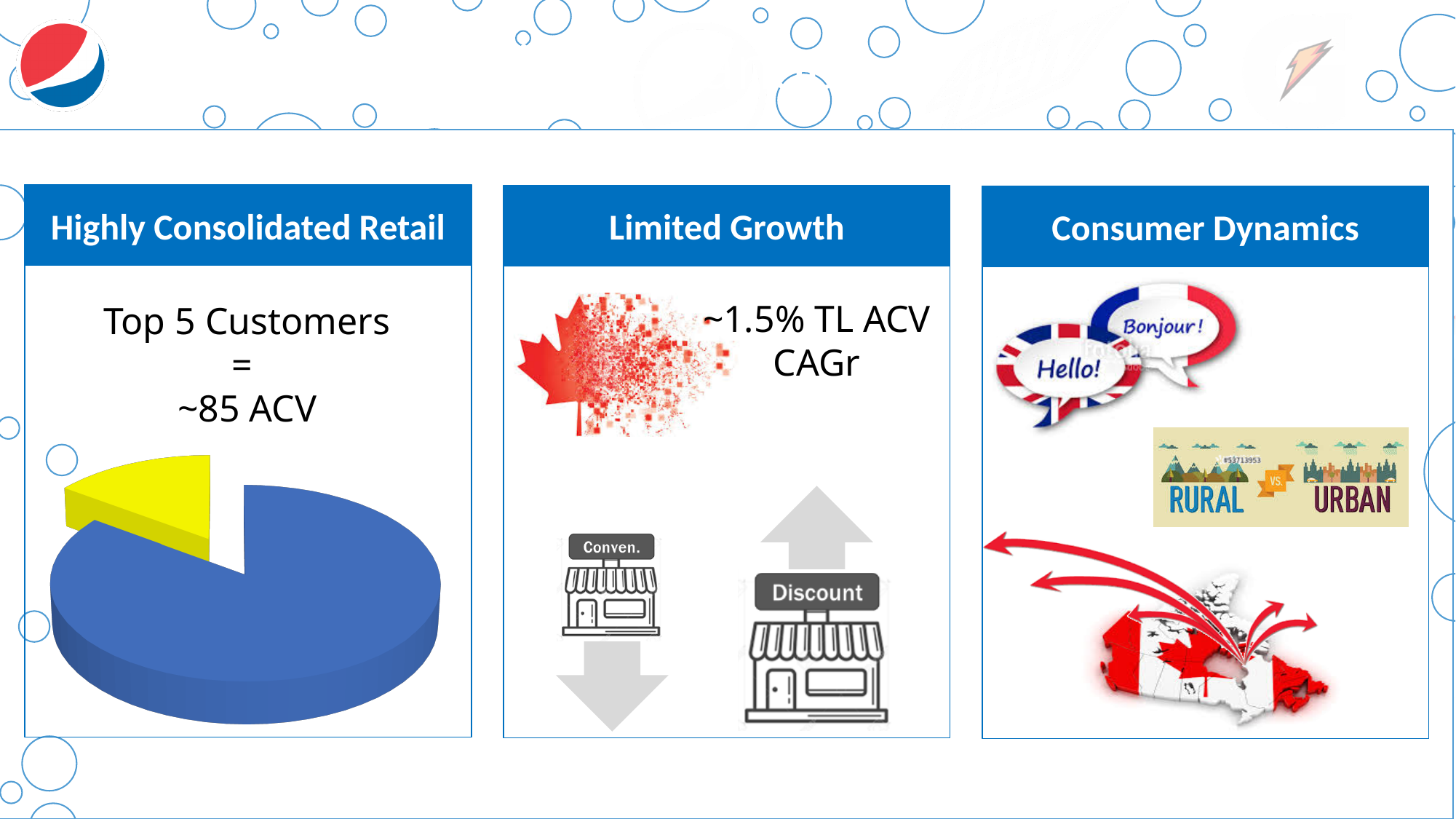
What kind of chart is shown under the "Highly Consolidated Retail" heading? pie chart How many slices does the pie chart under "Highly Consolidated Retail" have? 2 Is the pie chart under "Highly Consolidated Retail" drawn in 3D or flat 2D? 3D In the pie chart under "Highly Consolidated Retail", which colour slice is the smallest? yellow In the pie chart under "Highly Consolidated Retail", which colour slice is the largest? blue In the pie chart under "Highly Consolidated Retail", which slice is larger, the blue one or the yellow one? the blue one Which slice of the pie chart under "Highly Consolidated Retail" is pulled out (exploded) from the rest of the pie? the yellow slice